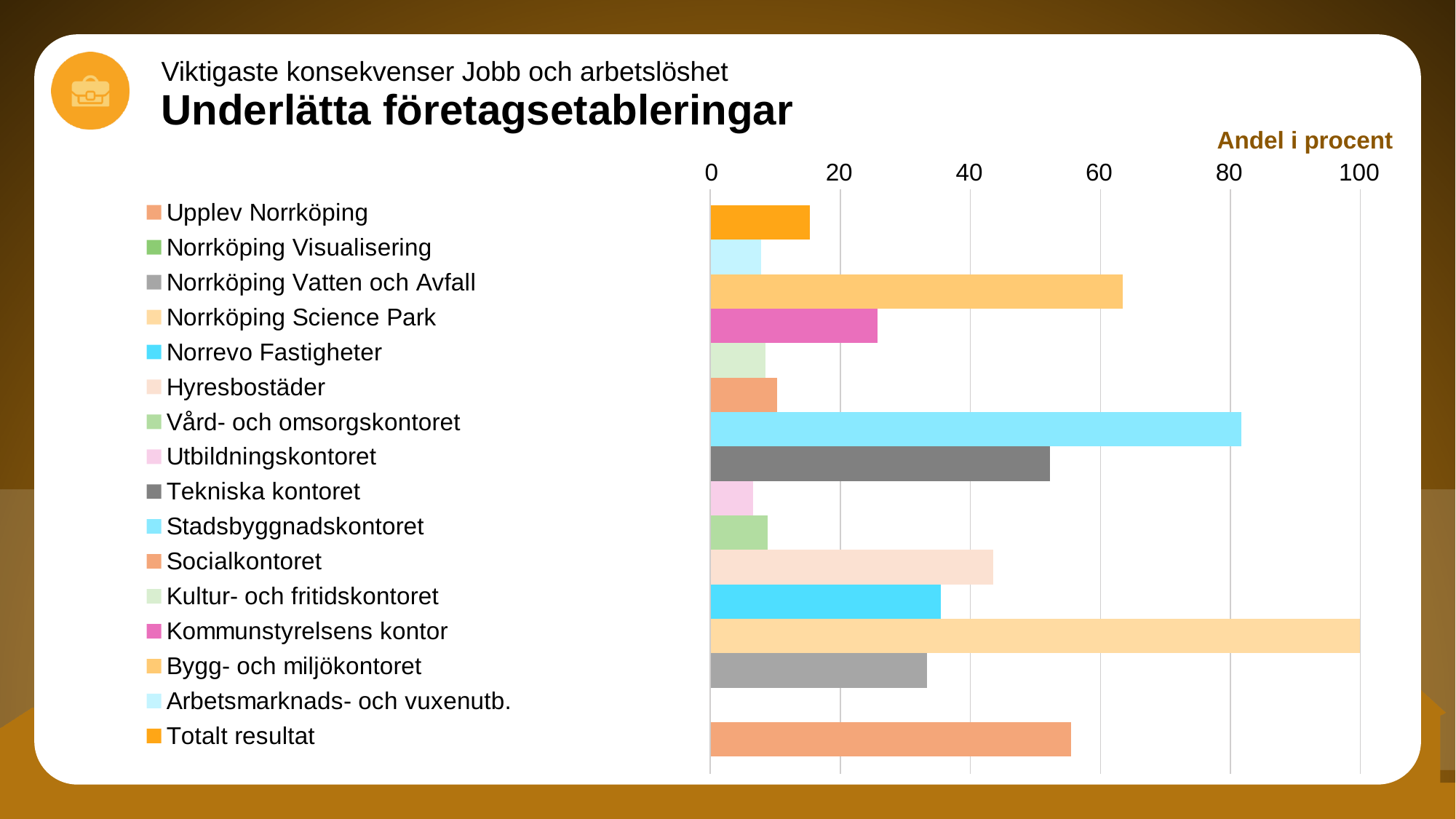
How many entries does the chart legend list? 16 Is the value for Tekniska kontoret greater or less than 40? greater Is the value for Bygg- och miljökontoret greater or less than 60? greater What label is shown above the horizontal axis of the chart? Andel i procent Is the value for Utbildningskontoret greater or less than 20? less What is the value for Norrköping Science Park? 100 Which legend entry has the highest value in the chart? Norrköping Science Park What kind of chart is shown on the slide? bar chart Which is larger, the value for Stadsbyggnadskontoret or the value for Tekniska kontoret? Stadsbyggnadskontoret Which is larger, the value for Hyresbostäder or the value for Kultur- och fritidskontoret? Hyresbostäder